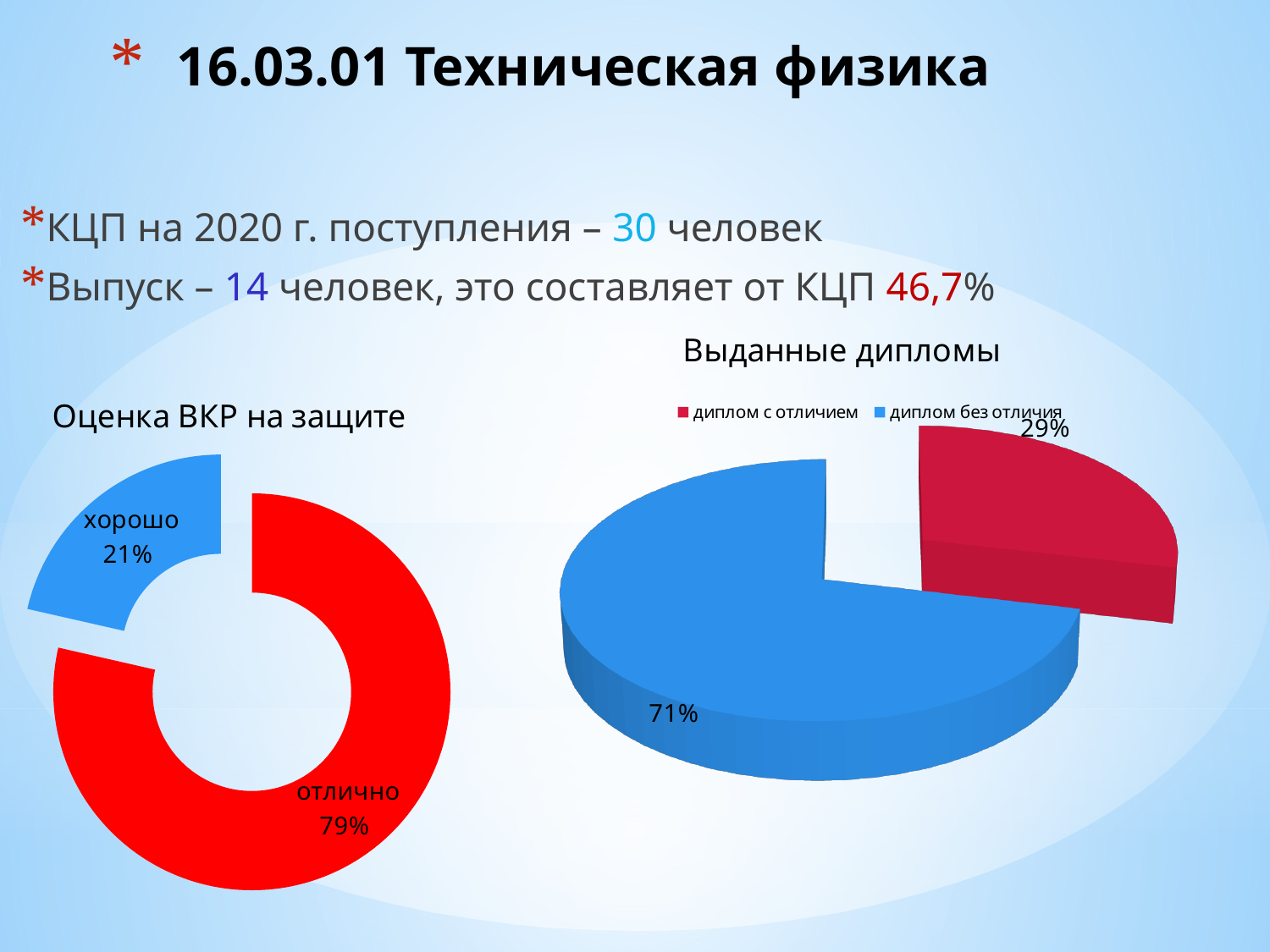
In the chart titled "Выданные дипломы", what colour is the slice for "диплом с отличием"? red In the chart titled "Выданные дипломы", which category is larger: "диплом с отличием" or "диплом без отличия"? диплом без отличия In the chart titled "Оценка ВКР на защите", what share is labelled "отлично"? 79% How many entries does the legend of the chart titled "Выданные дипломы" list? 2 In the chart titled "Выданные дипломы", what share is shown for "диплом с отличием"? 29% What kind of chart is the one titled "Оценка ВКР на защите"? doughnut chart In the chart titled "Оценка ВКР на защите", how many categories are shown? 2 In the chart titled "Оценка ВКР на защите", which category has the smallest share? хорошо In the chart titled "Оценка ВКР на защите", which category has the largest share? отлично In the chart titled "Оценка ВКР на защите", what is the difference in percentage points between "отлично" and "хорошо"? 58 In the chart titled "Выданные дипломы", what share is shown for "диплом без отличия"? 71% In the chart titled "Оценка ВКР на защите", what share is labelled "хорошо"? 21%